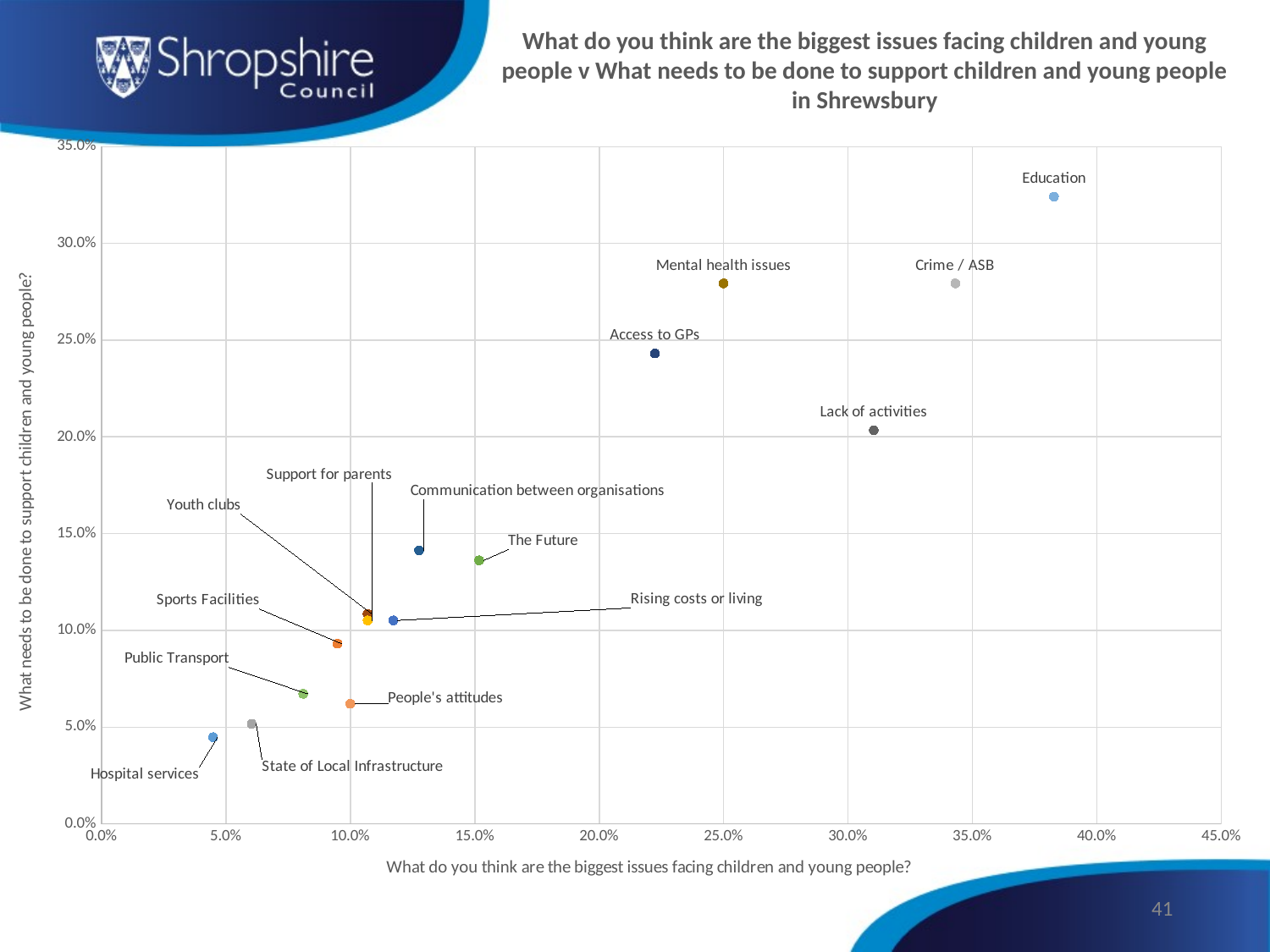
Is the horizontal-axis value for Lack of activities greater or less than 30.0%? greater What is the title of the horizontal axis? What do you think are the biggest issues facing children and young people? Is the vertical-axis value for Education greater or less than 30.0%? greater Which has a higher vertical-axis value, Lack of activities or Communication between organisations? Lack of activities Which issue has the lowest value on the vertical axis? Hospital services What kind of chart is shown on the slide? Scatter chart Which issue has the highest value on the vertical axis (What needs to be done to support children and young people)? Education Which issue has the highest value on the horizontal axis (biggest issues facing children and young people)? Education Is the vertical-axis value for Access to GPs greater or less than 25.0%? less Which issue has the lowest value on the horizontal axis? Hospital services Which has a higher horizontal-axis value, Crime / ASB or Mental health issues? Crime / ASB How many labelled data points are plotted on the chart? 15